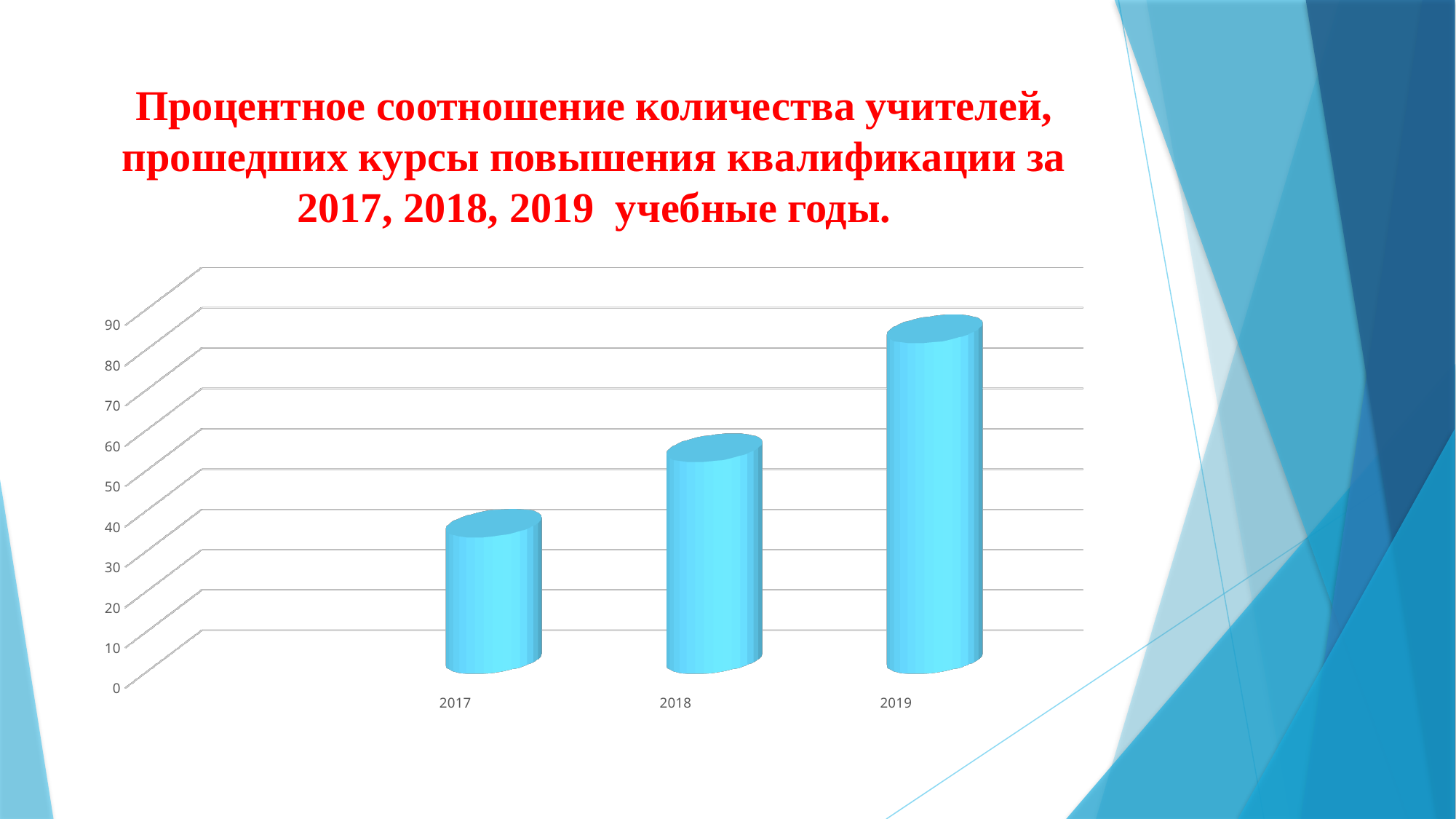
Which is larger, the value for 2019 or the value for 2018? 2019 Is the value for 2017 greater or less than 50? less Which is larger, the value for 2018 or the value for 2017? 2018 How many years (categories) are plotted on the chart? 3 Which years are listed on the x axis of the chart? 2017, 2018, 2019 Is the value for 2017 greater or less than 20? greater Do the values rise or fall from 2017 to 2019? rise Is the value for 2018 greater or less than 40? greater Which year has the highest value on the chart? 2019 Which year has the lowest value on the chart? 2017 What kind of chart is shown on the slide? bar chart